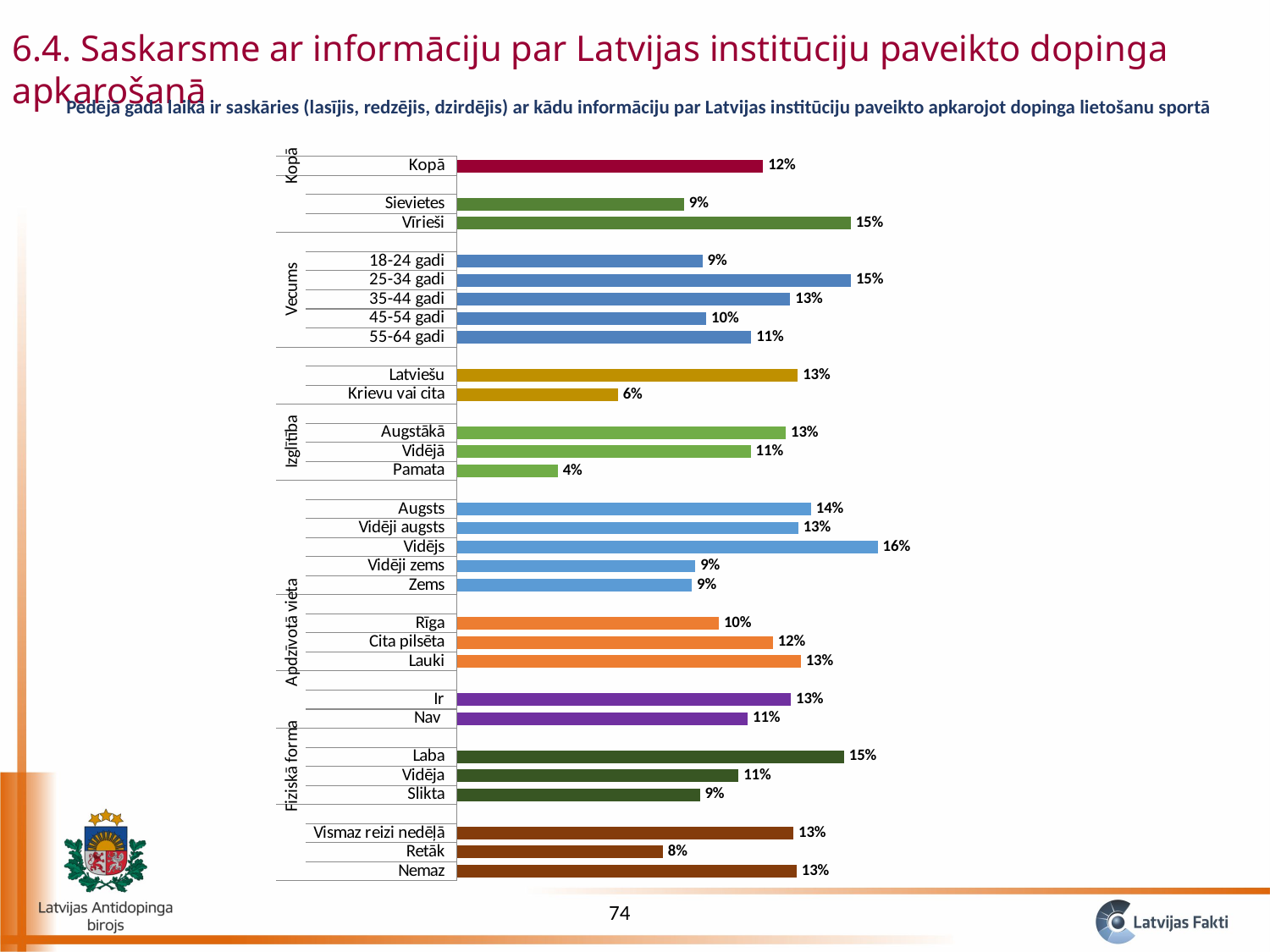
Which age group has the highest value? 25-34 gadi What is the value for Pamata? 4% What kind of chart is shown on the slide? Bar chart What is the value for Krievu vai cita? 6% What is the difference between the values for Vīrieši and Sievietes? 6% Which category has the highest value in the chart? Vidējs Which category has the lowest value in the chart? Pamata What is the difference between the values for Laba and Slikta? 6% How many bars are plotted in the chart? 29 What is the value for Retāk? 8% What is the value for Kopā? 12% Which is larger, the value for Rīga or the value for Lauki? Lauki